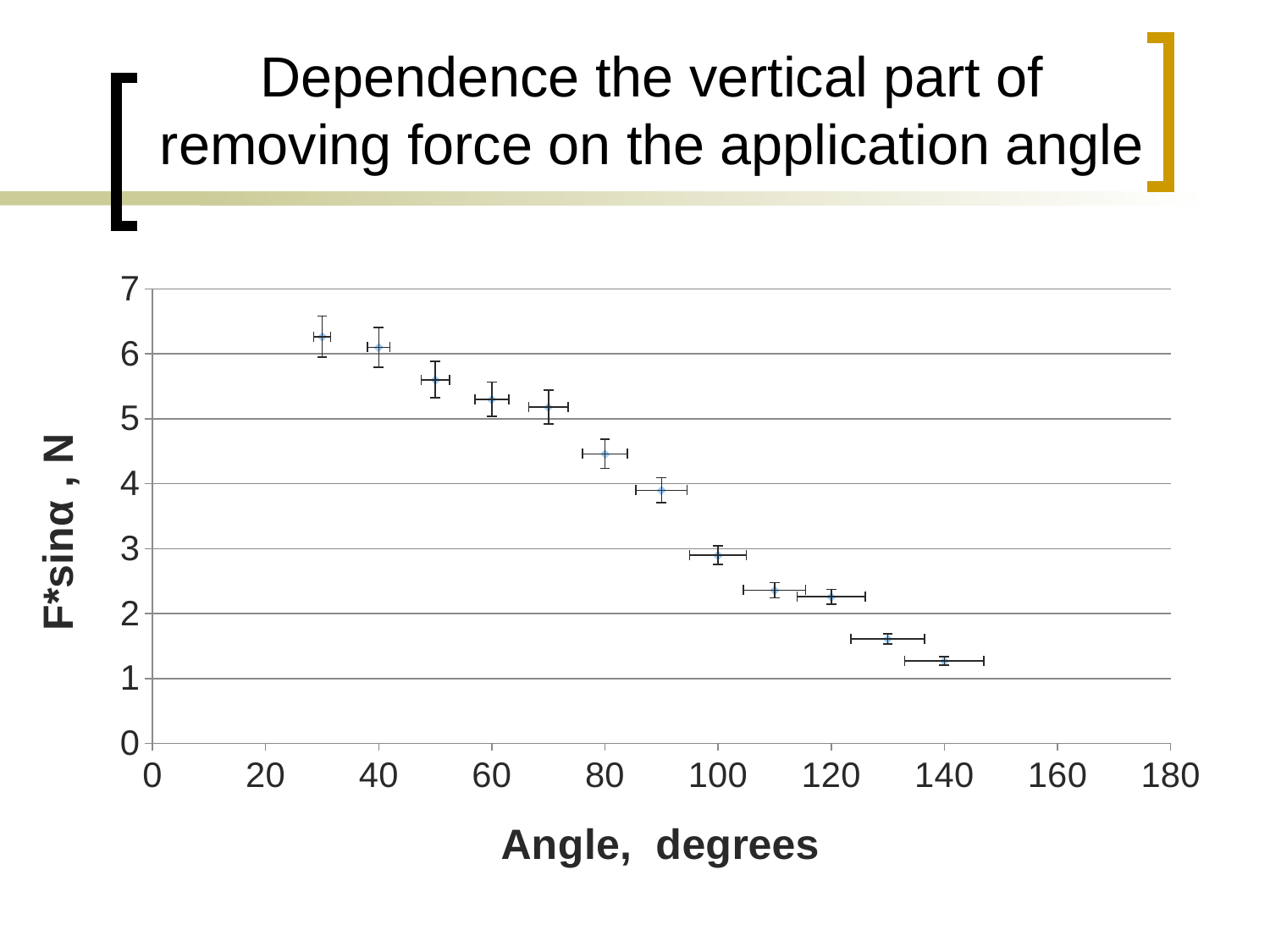
Which has the larger value of F*sinα: the point at 80 degrees or the point at 100 degrees? 80 degrees What kind of chart is shown on the slide? scatter chart What is the label of the y axis? F*sinα , N What is the label of the x axis? Angle, degrees Is the value for an angle of 30 degrees greater or less than 6? greater Is the value for an angle of 140 degrees greater or less than 1? greater Is the value for an angle of 100 degrees greater or less than 3? less At which angle is the plotted value of F*sinα lowest? 140 Do the values of F*sinα rise or fall as the angle increases along the x axis? fall How many data points are plotted on the chart? 12